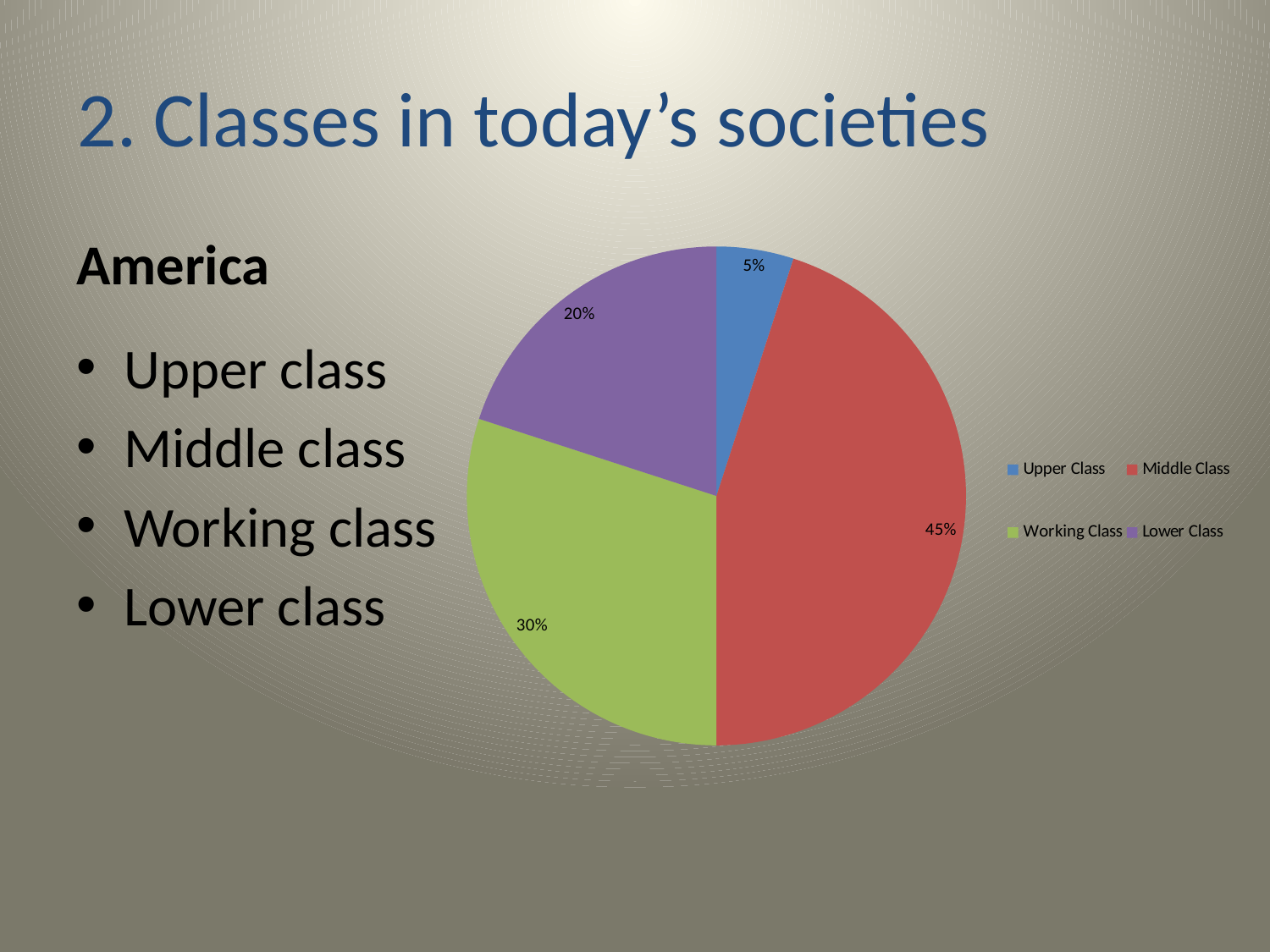
Which is larger, the Working Class slice or the Lower Class slice? Working Class What colour is the Middle Class slice in the pie chart? red What share of the pie does the Middle Class slice represent? 45% How many slices does the pie chart have? 4 Which class has the smallest slice of the pie? Upper Class What is the value shown for the Working Class slice? 30% What is the value shown for the Lower Class slice? 20% What is the difference between the Middle Class and Working Class shares? 15% What kind of chart is shown on the slide? pie chart Which class has the largest slice of the pie? Middle Class What is the value shown for the Upper Class slice? 5% What is the difference between the Lower Class and Upper Class shares? 15%